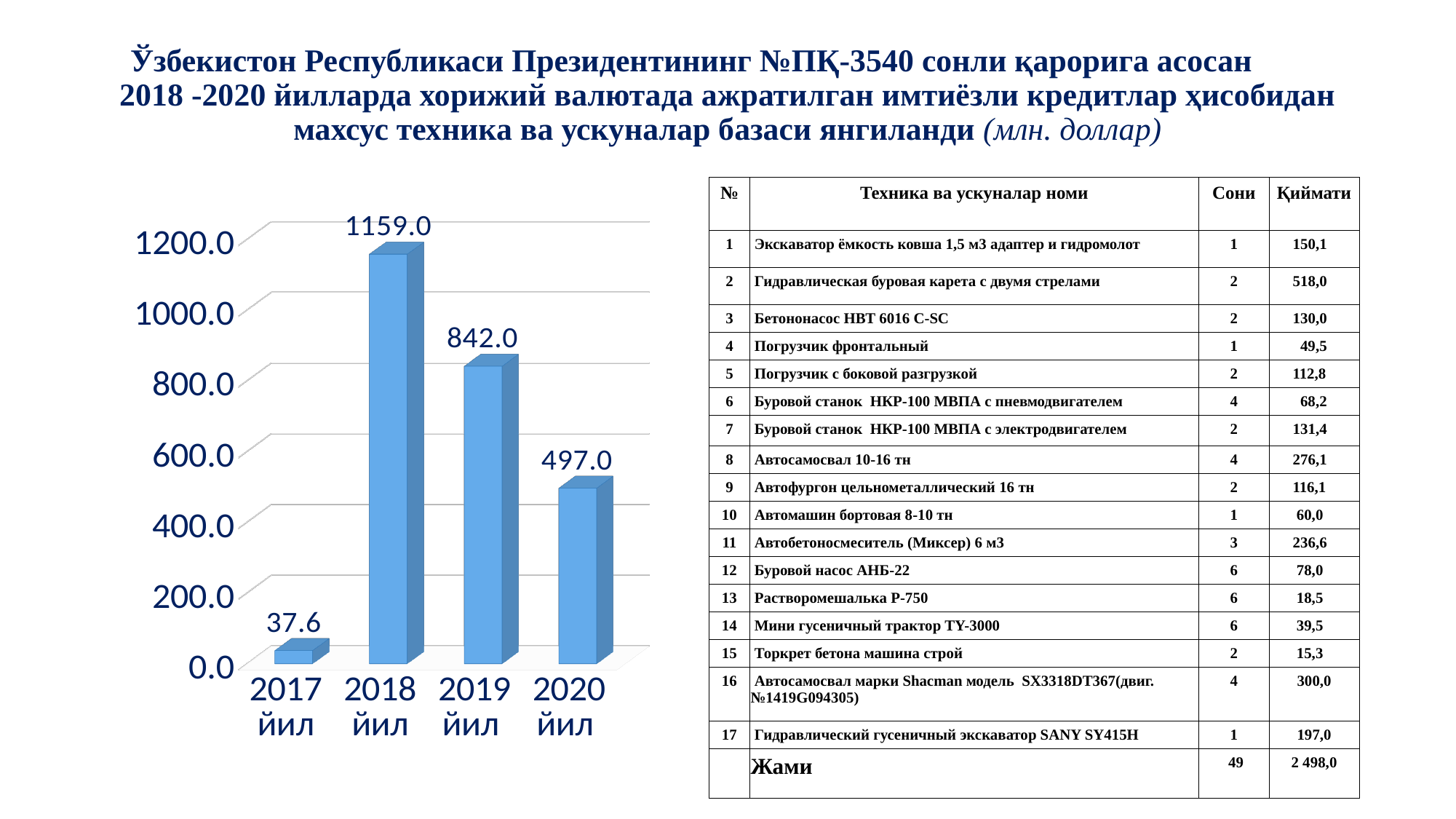
What is the value for 2020 йил? 497.0 What is the difference between the values for 2019 йил and 2020 йил? 345.0 What kind of chart is shown on the slide? bar chart What is the value for 2017 йил? 37.6 Which is larger, the value for 2019 йил or the value for 2020 йил? 2019 йил How many years are shown on the x axis of the chart? 4 Which year has the lowest value? 2017 йил Is the value for 2020 йил greater or less than 400.0? greater What is the difference between the values for 2018 йил and 2019 йил? 317.0 What is the value for 2018 йил? 1159.0 What is the value for 2019 йил? 842.0 Which year has the highest value? 2018 йил